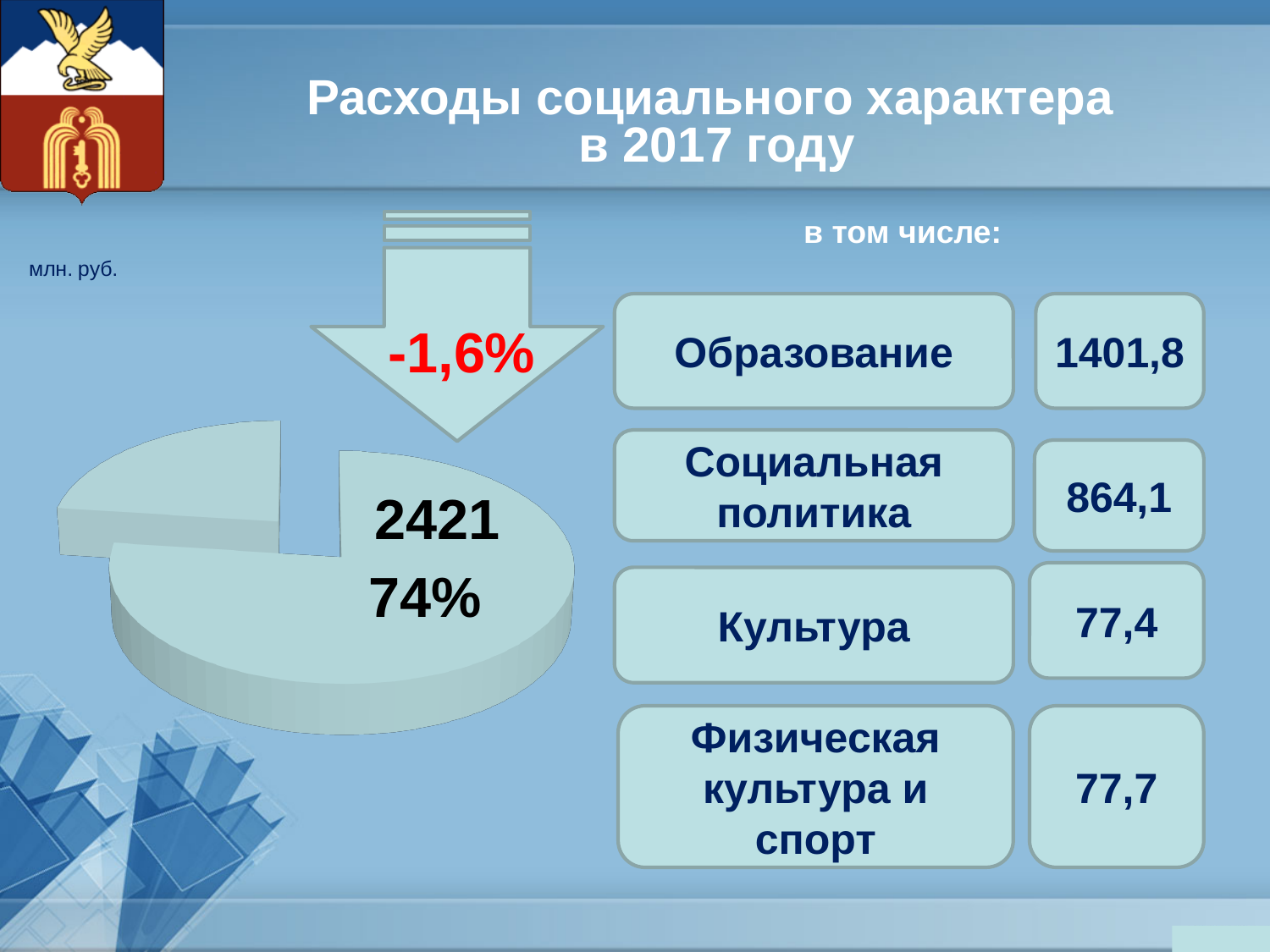
What percentage change is shown in the arrow above the pie chart? -1,6% In the breakdown next to the pie chart, which category has the lowest value? Культура How many slices does the pie chart have? 2 What value is printed on the large slice of the pie chart? 2421 What is the title of the slide containing the pie chart? Расходы социального характера в 2017 году What unit is indicated for the values on the slide? млн. руб. In the breakdown next to the pie chart, what is the value for Образование? 1401,8 Which slice of the pie chart is larger, the one labelled 74% or the unlabelled one? the one labelled 74% In the breakdown next to the pie chart, what is the difference between Образование and Социальная политика? 537,7 What share of the pie does the labelled slice represent? 74% What kind of chart is shown on the slide? pie chart Is the share of the labelled pie slice greater or less than 50%? greater